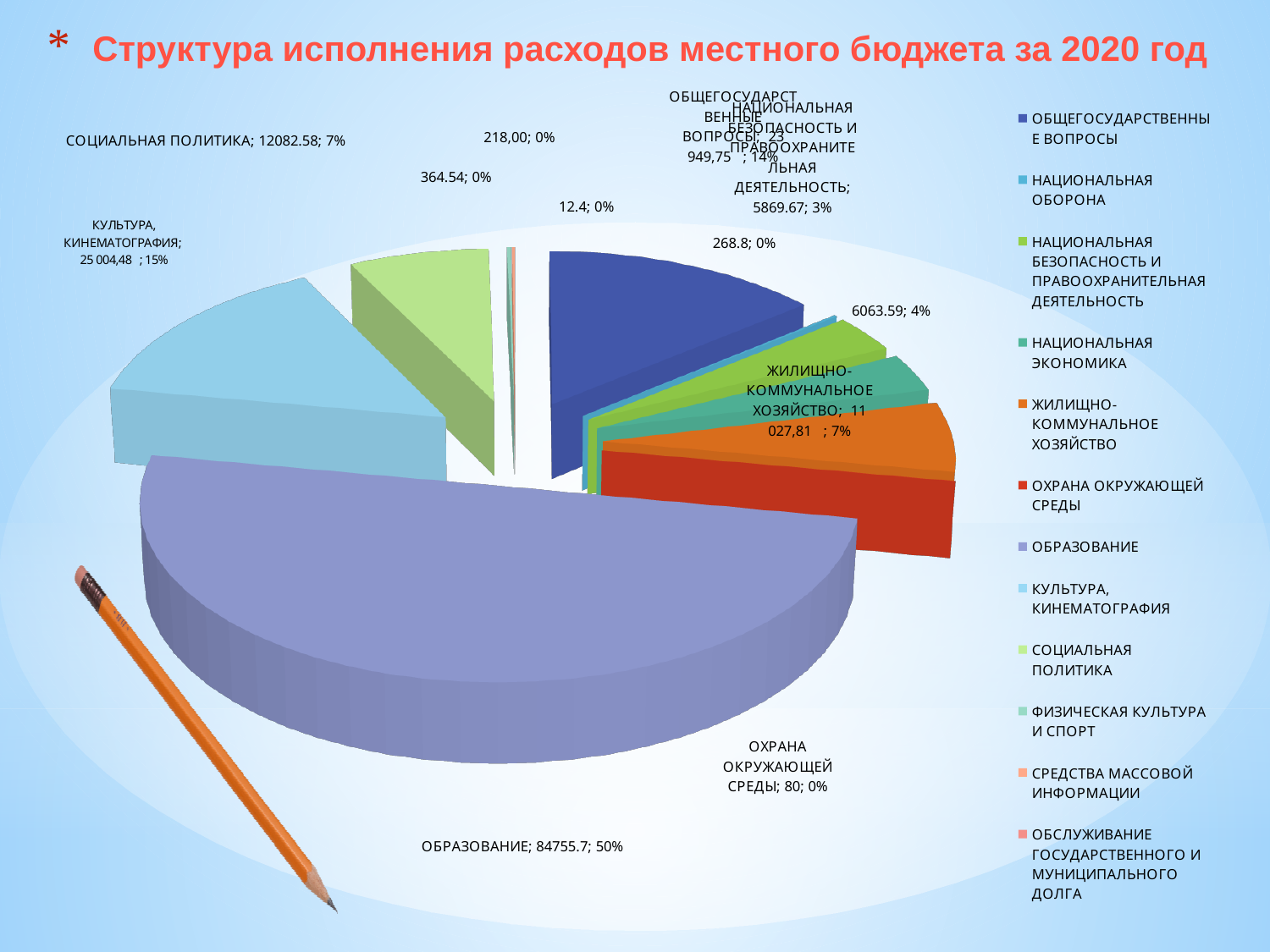
What share of the pie does ОБРАЗОВАНИЕ account for? 50% What share of the pie does КУЛЬТУРА, КИНЕМАТОГРАФИЯ account for? 15% What value is shown for ОБРАЗОВАНИЕ? 84755.7 How many categories does the legend list? 12 By how many percentage points does the share of ОБРАЗОВАНИЕ exceed the share of КУЛЬТУРА, КИНЕМАТОГРАФИЯ? 35 percentage points What value is shown for СОЦИАЛЬНАЯ ПОЛИТИКА? 12082.58 What is the title of the chart? Структура исполнения расходов местного бюджета за 2020 год What kind of chart is shown on the slide? Pie chart Which is larger: the slice for КУЛЬТУРА, КИНЕМАТОГРАФИЯ or the slice for СОЦИАЛЬНАЯ ПОЛИТИКА? КУЛЬТУРА, КИНЕМАТОГРАФИЯ Which category has the largest slice of the pie? ОБРАЗОВАНИЕ What value is shown for ОХРАНА ОКРУЖАЮЩЕЙ СРЕДЫ? 80 What share of the pie does НАЦИОНАЛЬНАЯ БЕЗОПАСНОСТЬ И ПРАВООХРАНИТЕЛЬНАЯ ДЕЯТЕЛЬНОСТЬ account for? 3%